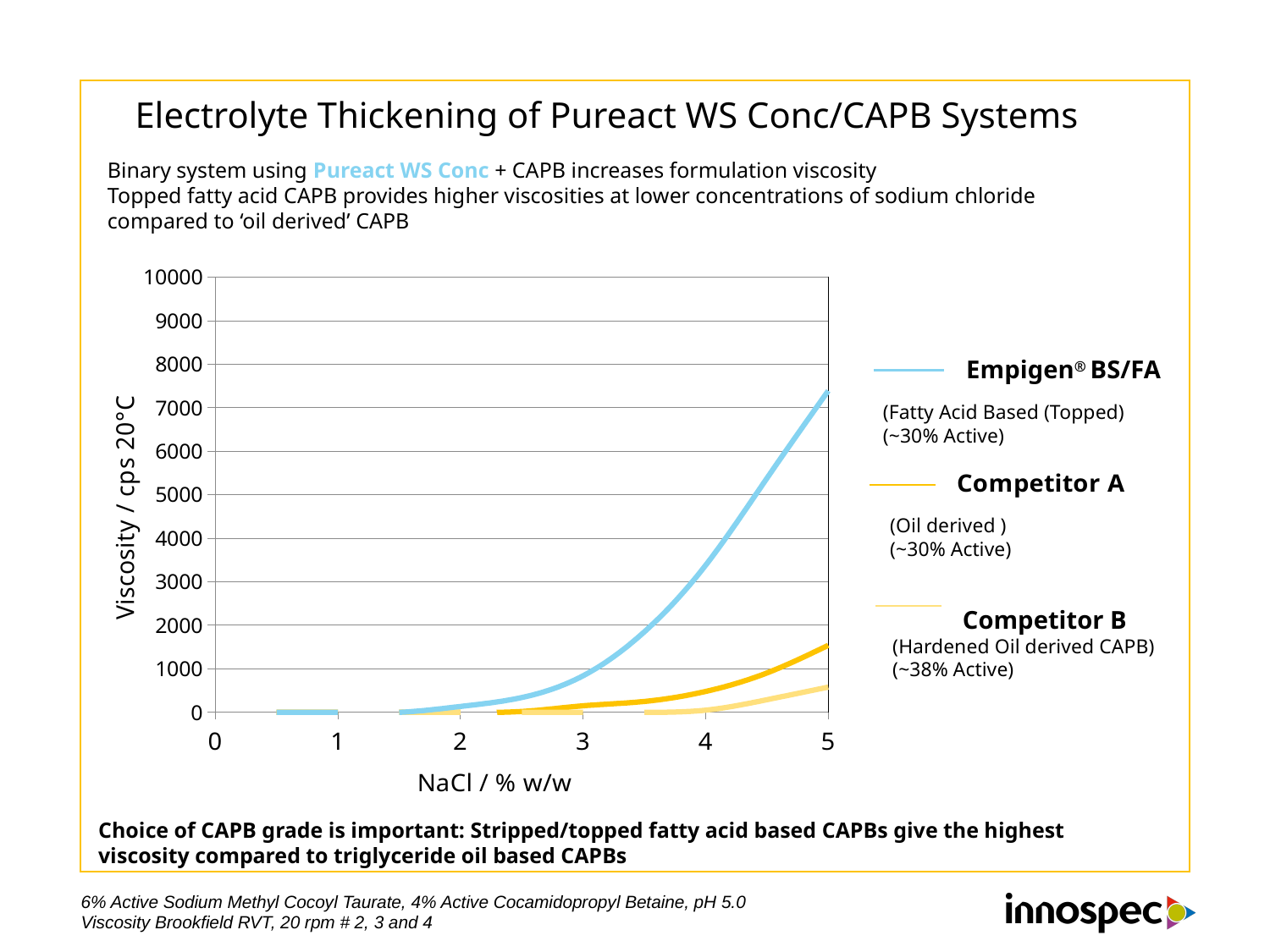
Which series has the lowest viscosity at 5% NaCl? Competitor B Which series has the highest viscosity at 5% NaCl? Empigen BS/FA Is the viscosity of Competitor B at 5% NaCl greater or less than 1000? less How many series does the legend list? 3 What kind of chart is shown on the slide? Line chart Does the viscosity of Empigen BS/FA rise or fall as NaCl concentration increases? Rise Is the viscosity of Empigen BS/FA at 5% NaCl greater or less than 7000? greater What is the label of the y axis? Viscosity / cps 20°C What is the label of the x axis? NaCl / % w/w Is the viscosity of Competitor A at 5% NaCl greater or less than 1000? greater At 5% NaCl, which has the higher viscosity: Competitor A or Competitor B? Competitor A